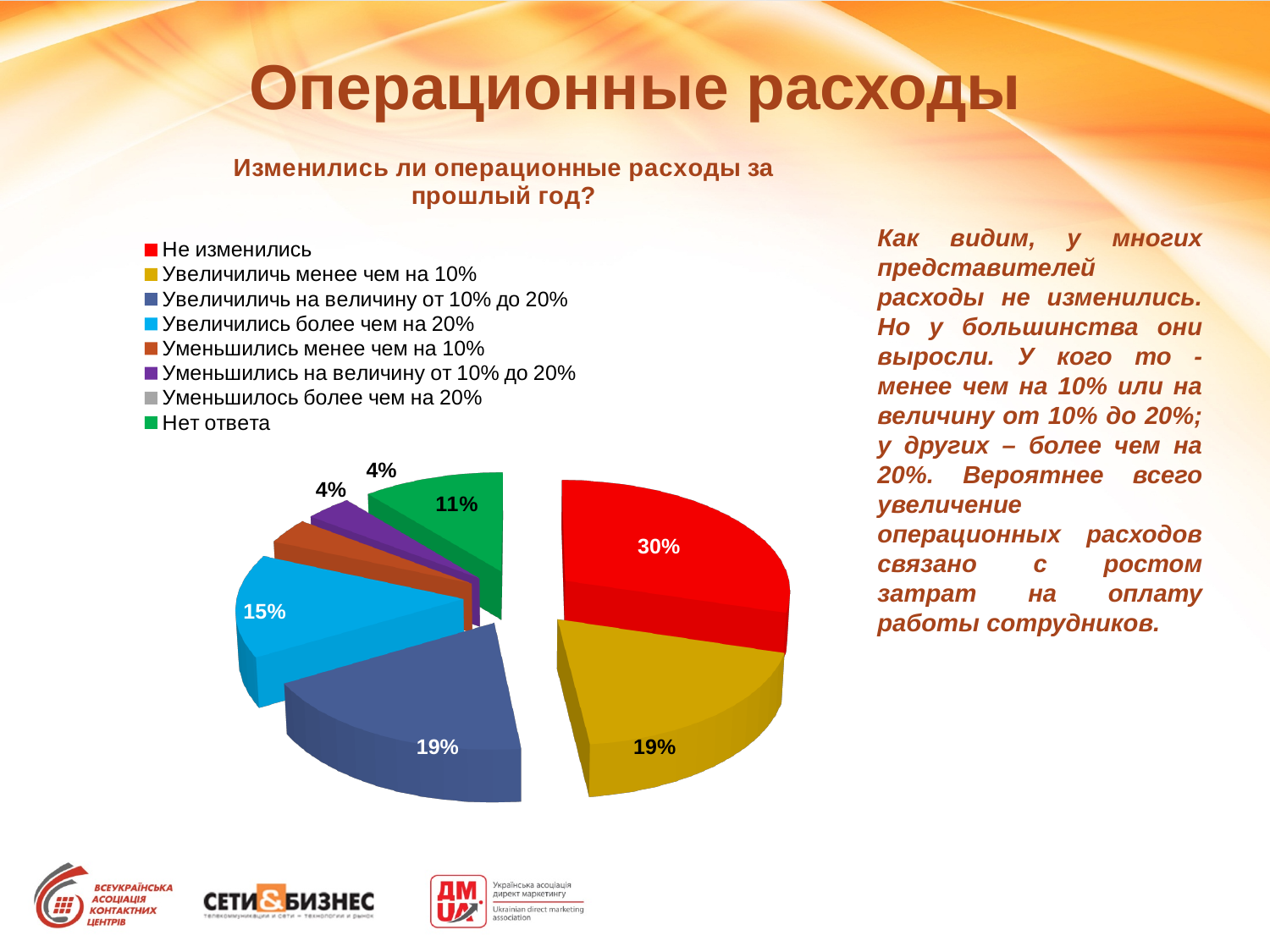
What share of the pie does "Увеличилич менее чем на 10%" represent? 19% What is the difference in percentage points between "Не изменились" and "Нет ответа"? 19 Which category has the largest share of the pie? Не изменились What share of the pie does "Нет ответа" represent? 11% How many entries does the legend list? 8 What share of the pie does "Увеличились более чем на 20%" represent? 15% What share of the pie does "Не изменились" represent? 30% What colour is the slice for "Не изменились"? Red What kind of chart is shown on the slide? Pie chart Which is larger: the share for "Увеличились более чем на 20%" or the share for "Нет ответа"? Увеличились более чем на 20% What is the title of the chart? Изменились ли операционные расходы за прошлый год? What is the difference in percentage points between "Увеличились более чем на 20%" and "Уменьшились менее чем на 10%"? 11